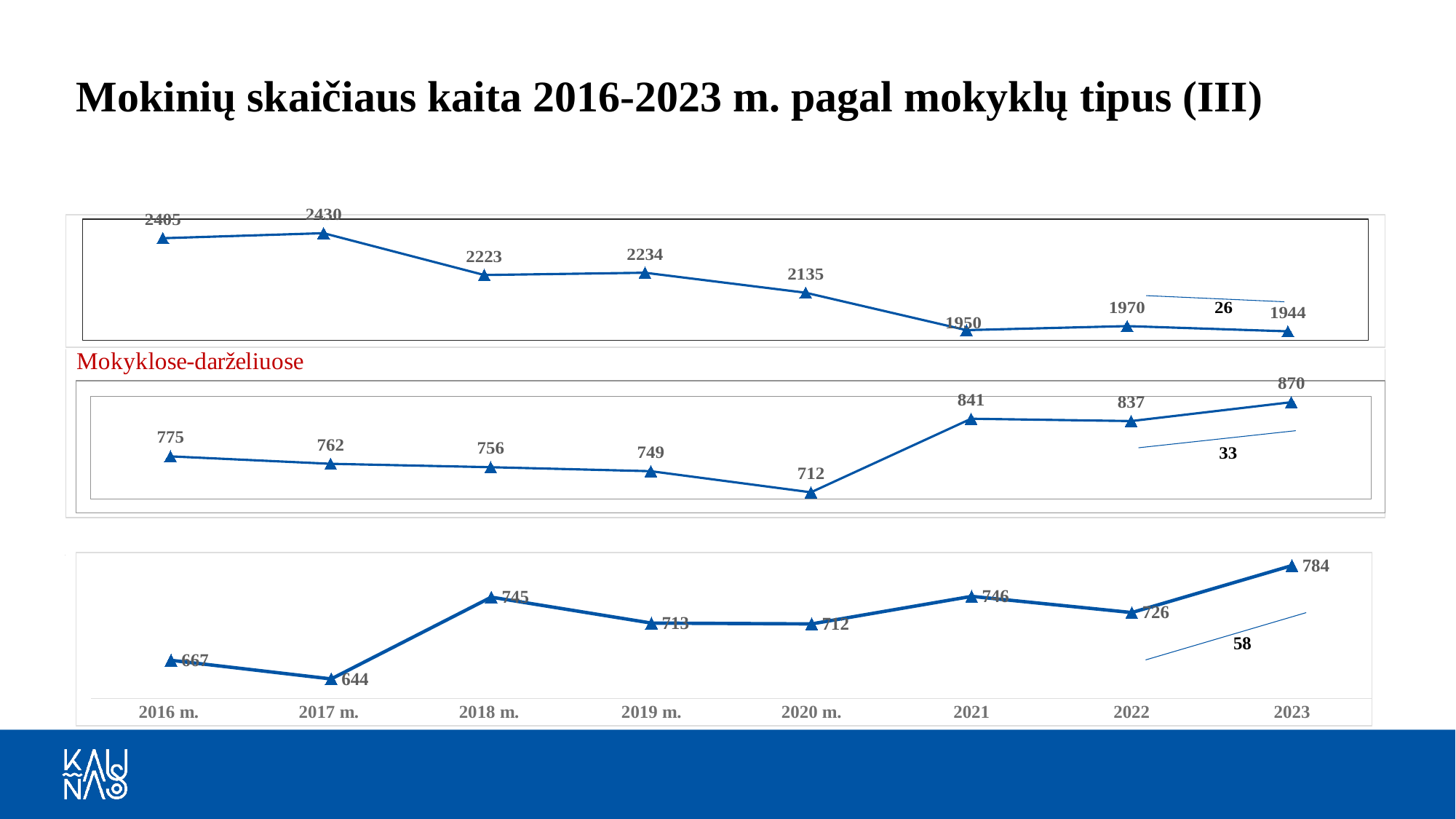
In the top chart, what is the value for 2017 m.? 2430 In the bottom chart, by how much does the value increase from 2022 to 2023? 58 In the middle chart (Mokyklose-darželiuose), by how much does the value increase from 2022 to 2023? 33 In the middle chart (Mokyklose-darželiuose), which year has the highest value? 2023 How many data points does the bottom chart plot? 8 In the bottom chart, what is the value for 2023? 784 In the bottom chart, which year has the lowest value? 2017 m. In the top chart, do the values generally rise or fall from 2016 m. to 2023? Fall In the middle chart (Mokyklose-darželiuose), which is larger: the value for 2016 m. or the value for 2021? 2021 In the top chart, what is the difference between the values for 2022 and 2023? 26 In the middle chart (Mokyklose-darželiuose), what is the value for 2020 m.? 712 What kind of chart is the top chart? Line chart